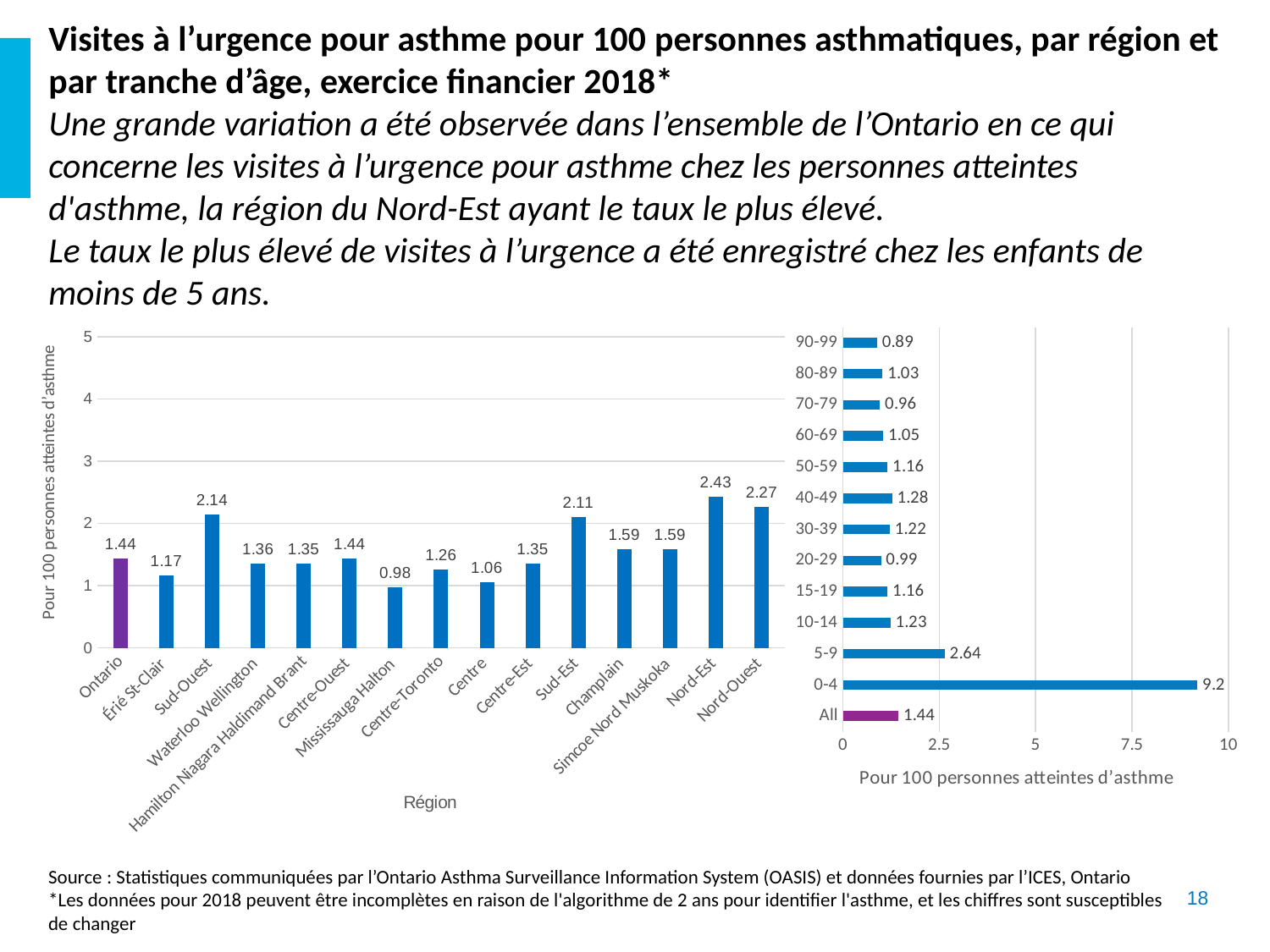
In the left chart by region, which region has the lowest value? Mississauga Halton In the right chart by age group, what is the value for the 5-9 age group? 2.64 In the left chart by region, what is the value for Mississauga Halton? 0.98 In the left chart by region, what is the difference between Sud-Ouest and Érié St-Clair? 0.97 In the right chart by age group, what is the value for the 0-4 age group? 9.2 In the right chart by age group, which age group has the lowest value? 90-99 In the right chart by age group, which is larger, 40-49 or 30-39? 40-49 What kind of chart is the right chart by age group? Bar chart In the left chart by region, how many bars are plotted? 15 In the right chart by age group, what is the difference between the 0-4 and 5-9 age groups? 6.56 In the left chart by region, which region has the highest value? Nord-Est In the left chart by region, what is the value for Nord-Est? 2.43